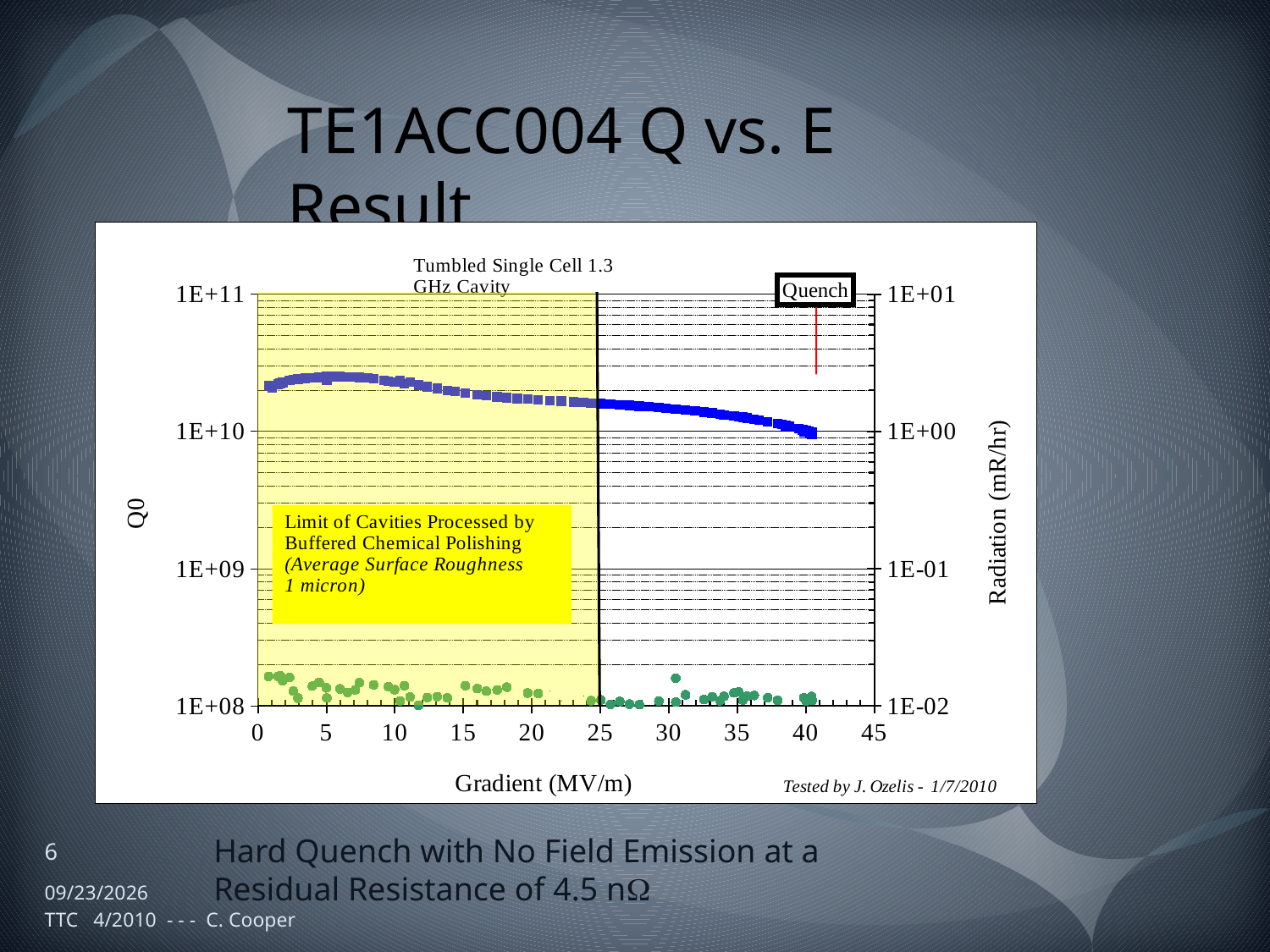
What is the label of the right-hand vertical axis? Radiation (mR/hr) Is the Q0 value at a gradient of 20 MV/m greater or less than 1E+10? greater At what gradient does the yellow shaded region end? 25 Is the gradient at which the Quench marker is placed greater or less than 35 MV/m? greater What kind of chart is shown on the slide? scatter chart Does Q0 rise or fall as the gradient increases from 10 MV/m to 40 MV/m? fall What is the highest value shown on the Gradient (MV/m) axis? 45 Is the radiation value at a gradient of 30 MV/m greater or less than 1E-01 mR/hr? less What is the title printed above the chart? Tumbled Single Cell 1.3 GHz Cavity Which is larger, the Q0 value at 5 MV/m or the Q0 value at 35 MV/m? Q0 at 5 MV/m